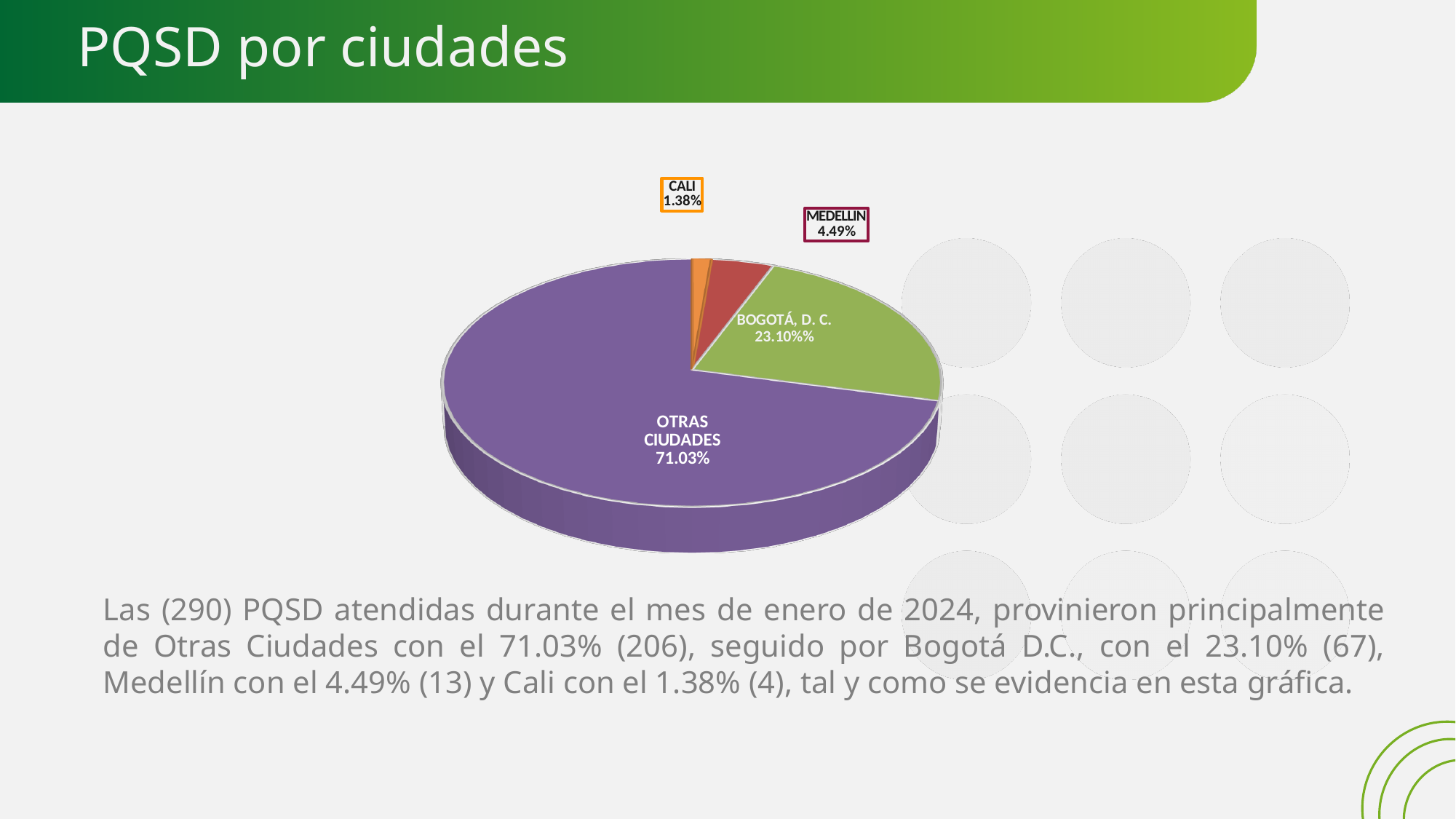
What is the difference in percentage points between Otras Ciudades and Bogotá, D. C.? 47.93 What kind of chart is shown on the slide? pie chart What colour is the Otras Ciudades slice? purple Which city has the smallest slice of the pie? Cali Which is larger, the share for Medellín or the share for Cali? Medellín What percentage is shown for Bogotá, D. C.? 23.10% Which city category has the largest slice of the pie? Otras Ciudades What is the difference in percentage points between Medellín and Cali? 3.11 How many slices does the pie chart have? 4 What percentage is shown for Cali? 1.38% What share of the pie does Otras Ciudades hold? 71.03% What percentage is shown for Medellín? 4.49%